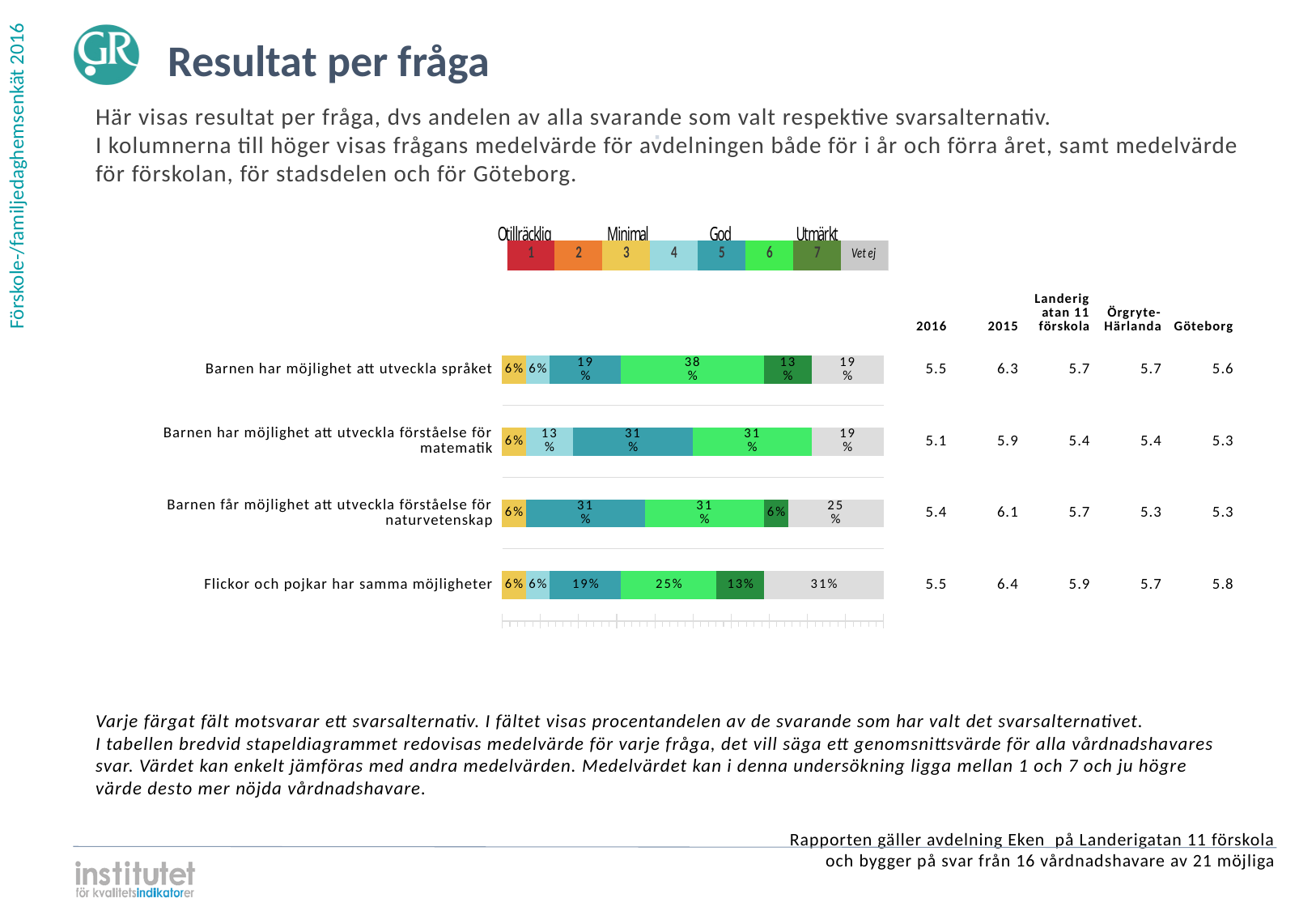
In the table next to the chart, what is the 2016 mean value for "Barnen har möjlighet att utveckla förståelse för matematik"? 5.1 What percentage of respondents chose option 6 for "Barnen har möjlighet att utveckla språket"? 38% What label does the legend give to the grey segment at the right end of each bar? Vet ej Which is larger: the option 7 share for "Barnen får möjlighet att utveckla förståelse för naturvetenskap" or for "Flickor och pojkar har samma möjligheter"? Flickor och pojkar har samma möjligheter How many response options does the legend above the chart list? 8 What kind of chart is shown on the slide? Stacked bar chart Which question has the largest "Vet ej" share? Flickor och pojkar har samma möjligheter Which question has the largest share for option 6? Barnen har möjlighet att utveckla språket What percentage chose option 5 for "Barnen har möjlighet att utveckla förståelse för matematik"? 31% How many questions (categories) are plotted in the bar chart? 4 What is the difference between the option 6 share for "Barnen har möjlighet att utveckla språket" (38%) and for "Flickor och pojkar har samma möjligheter" (25%)? 13 percentage points What percentage chose "Vet ej" for "Flickor och pojkar har samma möjligheter"? 31%